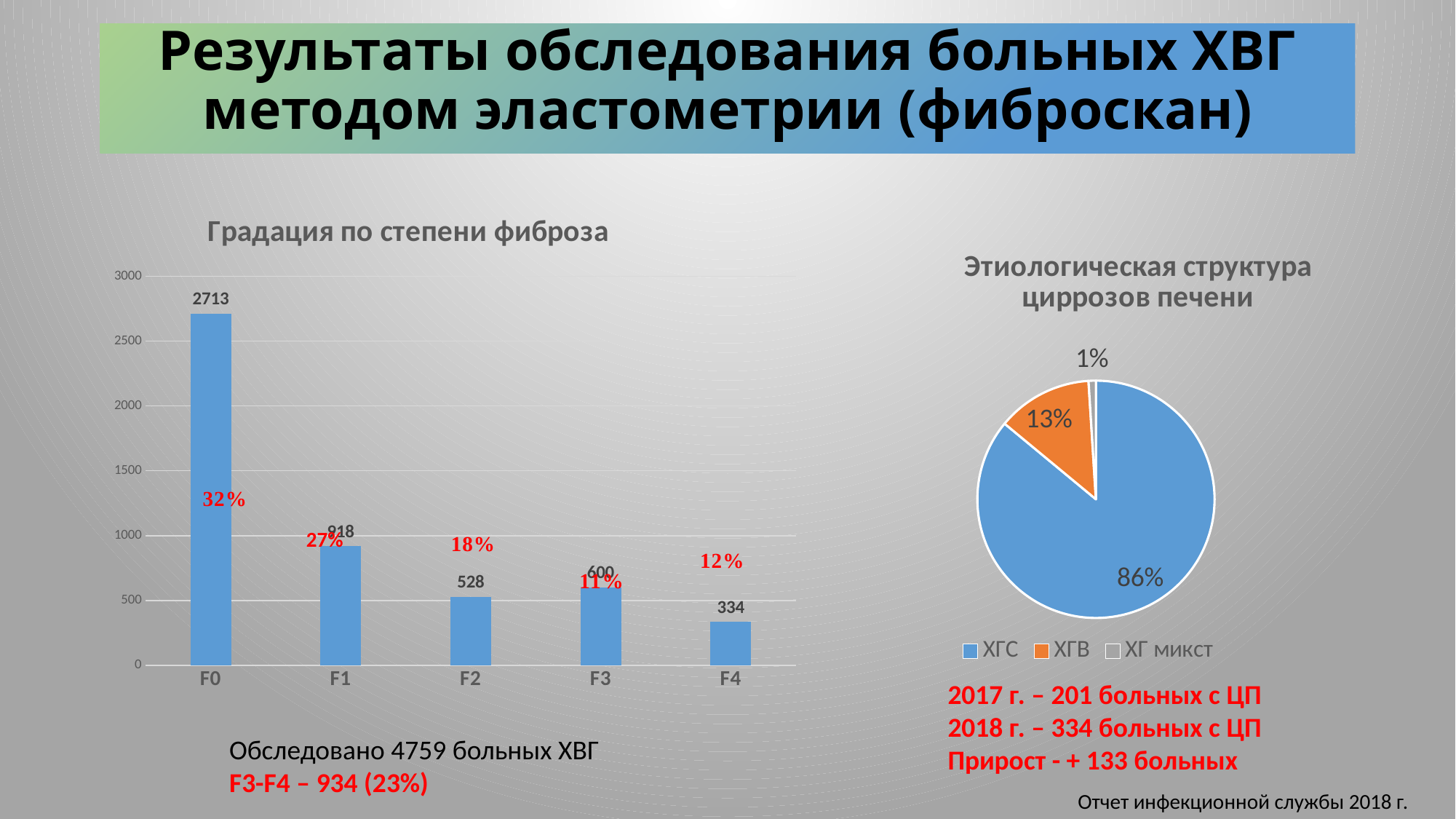
In the chart 'Градация по степени фиброза', which category has the lowest value? F4 In the chart 'Градация по степени фиброза', which is larger, the value for F3 or the value for F4? F3 In the chart 'Градация по степени фиброза', what is the value for F0? 2713 In the pie chart 'Этиологическая структура циррозов печени', which category has the largest slice? ХГС In the chart 'Градация по степени фиброза', how many categories are shown on the x axis? 5 In the chart 'Градация по степени фиброза', what is the difference between the values for F3 and F2? 72 In the pie chart 'Этиологическая структура циррозов печени', what share does ХГВ have? 13% In the chart 'Градация по степени фиброза', what is the value for F2? 528 In the chart 'Градация по степени фиброза', which category has the highest value? F0 In the chart 'Градация по степени фиброза', what is the value for F4? 334 How many entries does the legend of the pie chart 'Этиологическая структура циррозов печени' list? 3 What kind of chart is 'Градация по степени фиброза'? Bar chart